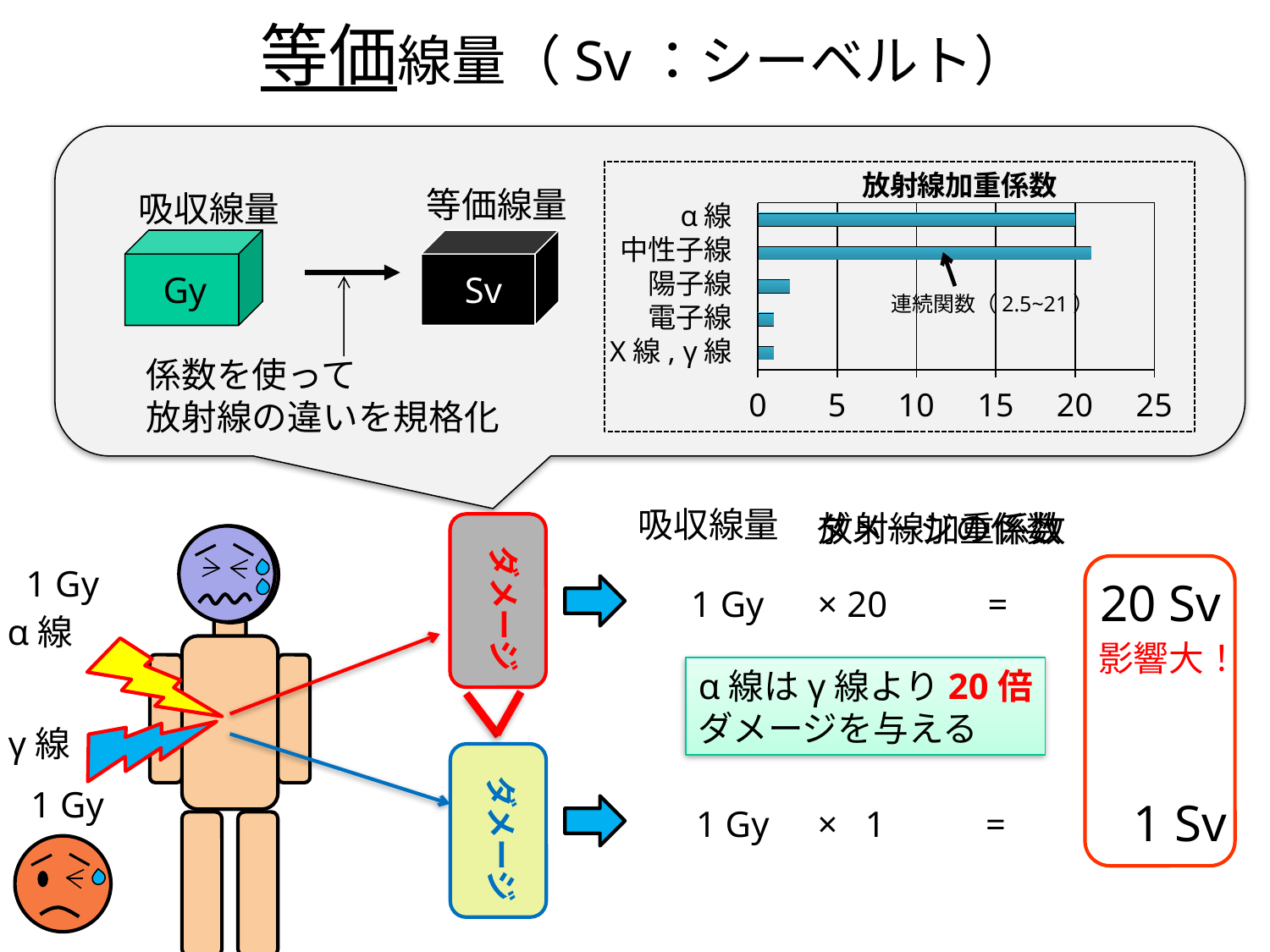
In the 放射線加重係数 chart, is the value for X線,γ線 greater or less than 5? less In the 放射線加重係数 chart, what is the weighting factor for α線? 20 What kind of chart is shown in the 放射線加重係数 panel? bar chart What annotation is attached to the 中性子線 bar in the 放射線加重係数 chart? 連続関数（2.5~21） In the 放射線加重係数 chart, which is larger, the value for α線 or the value for 陽子線? α線 In the 放射線加重係数 chart, is the value for 陽子線 greater or less than 5? less In the 放射線加重係数 chart, which radiation type has the highest weighting factor? 中性子線 In the 放射線加重係数 chart, is the value for 電子線 greater or less than 5? less How many radiation types (categories) are plotted in the 放射線加重係数 chart? 5 What is the title of the bar chart on the slide? 放射線加重係数 In the 放射線加重係数 chart, which is larger, the value for 陽子線 or the value for 電子線? 陽子線